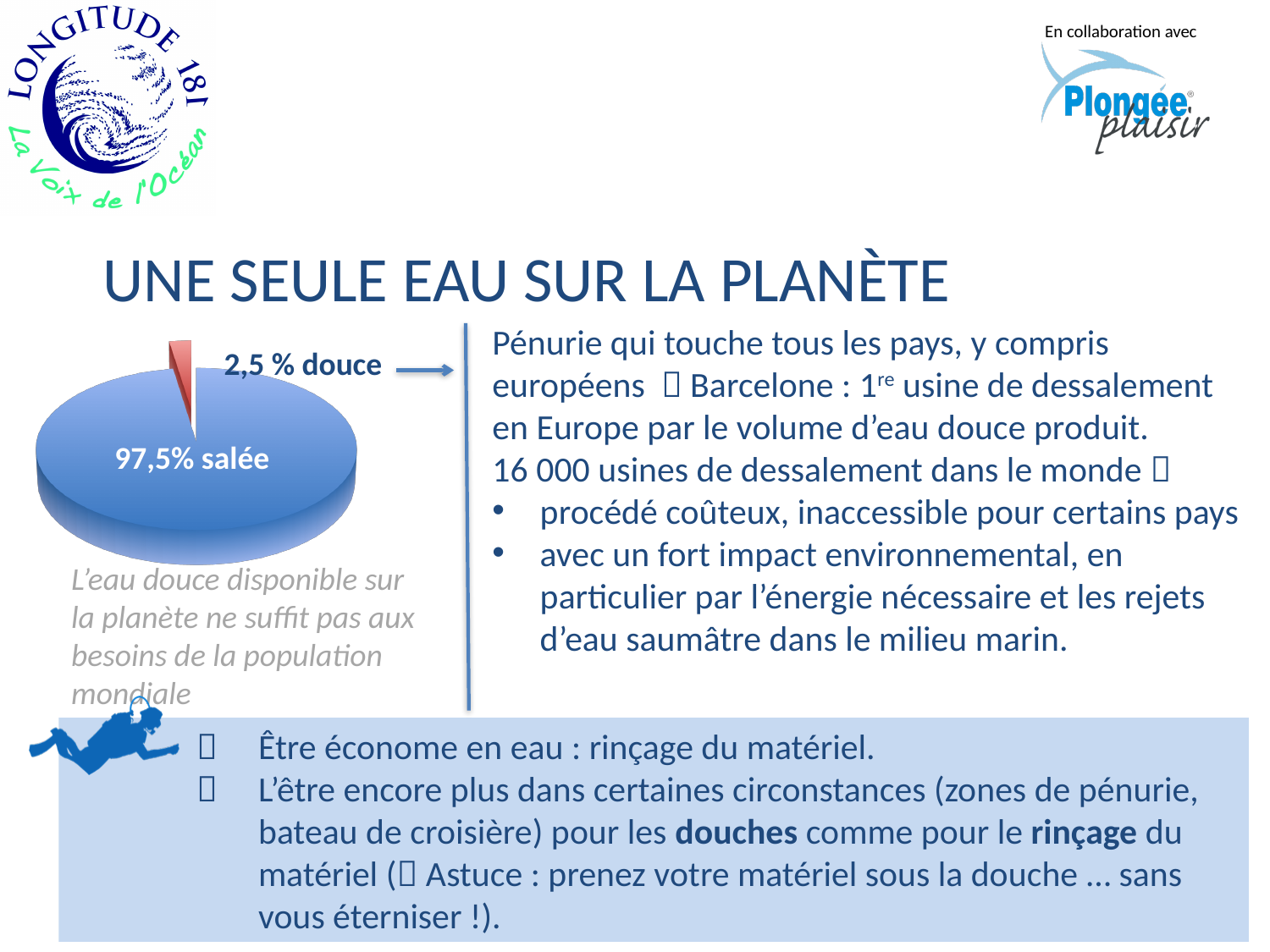
What share of the pie is labelled "salée"? 97,5% Which slice of the pie chart is the largest? salée What colour is the "salée" slice of the pie chart? blue Which slice of the pie chart is the smallest? douce What colour is the "douce" slice of the pie chart? red What share of the pie is labelled "douce"? 2,5 % What kind of chart is shown on the slide? pie chart How many slices does the pie chart have? 2 What is the difference in percentage points between the "salée" slice and the "douce" slice? 95 percentage points Which is larger in the pie chart, the "salée" slice or the "douce" slice? salée